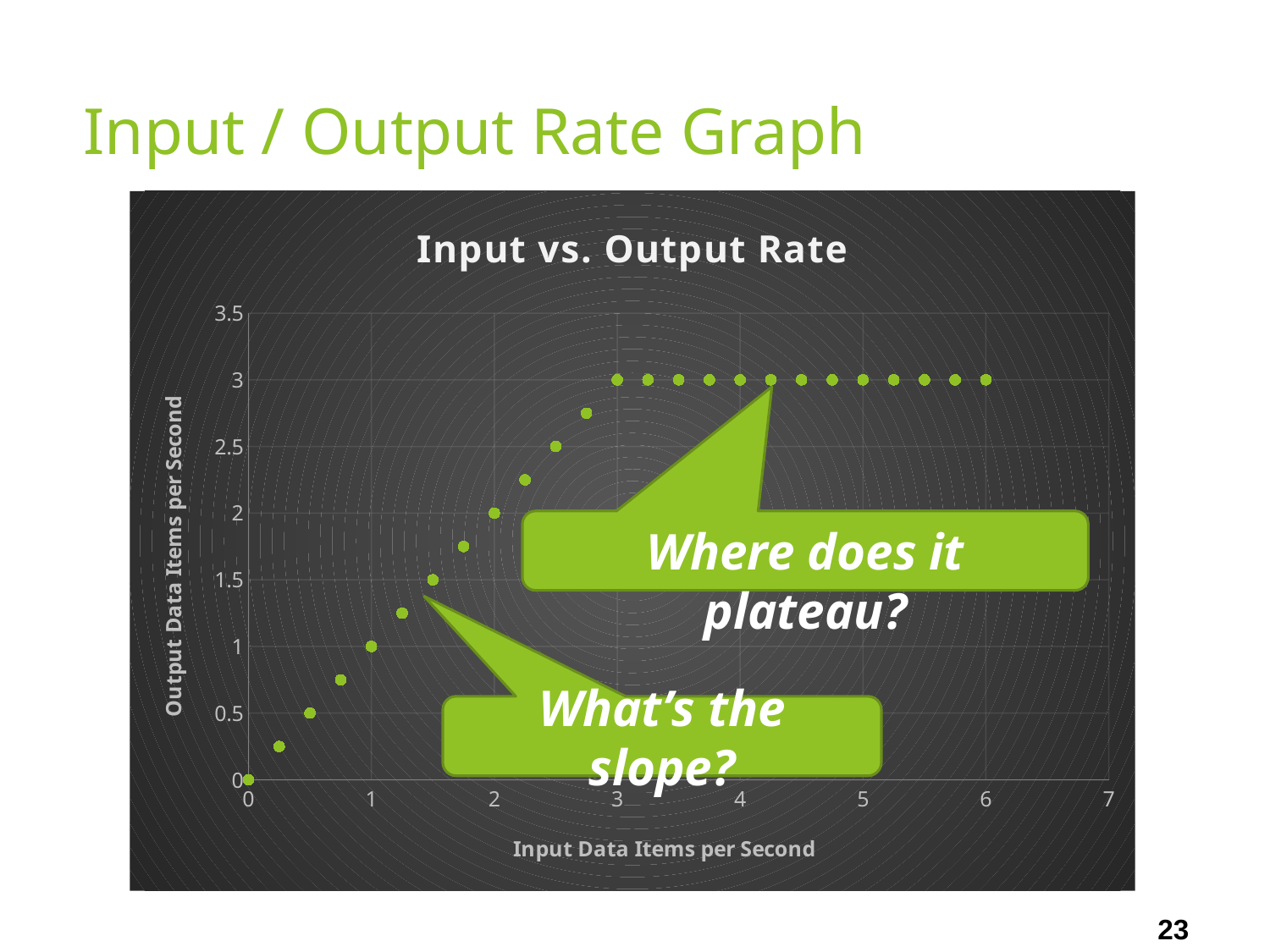
Which is larger, the output rate at an input rate of 2 or at an input rate of 4? input rate of 4 What is the output rate when the input rate is 3 data items per second? 3 What is the highest output rate reached on the chart? 3 What is the title of the chart? Input vs. Output Rate What is the output rate when the input rate is 6 data items per second? 3 Is the output rate at an input rate of 0.5 greater or less than 1? less What kind of chart is shown on the slide? scatter chart What is the label of the y axis? Output Data Items per Second What is the output rate when the input rate is 2 data items per second? 2 Is the output rate at an input rate of 5 greater or less than 2.5? greater What is the output rate when the input rate is 1 data item per second? 1 How does the output rate change as the input rate increases from 0 to 6? rises until input 3, then stays flat at 3